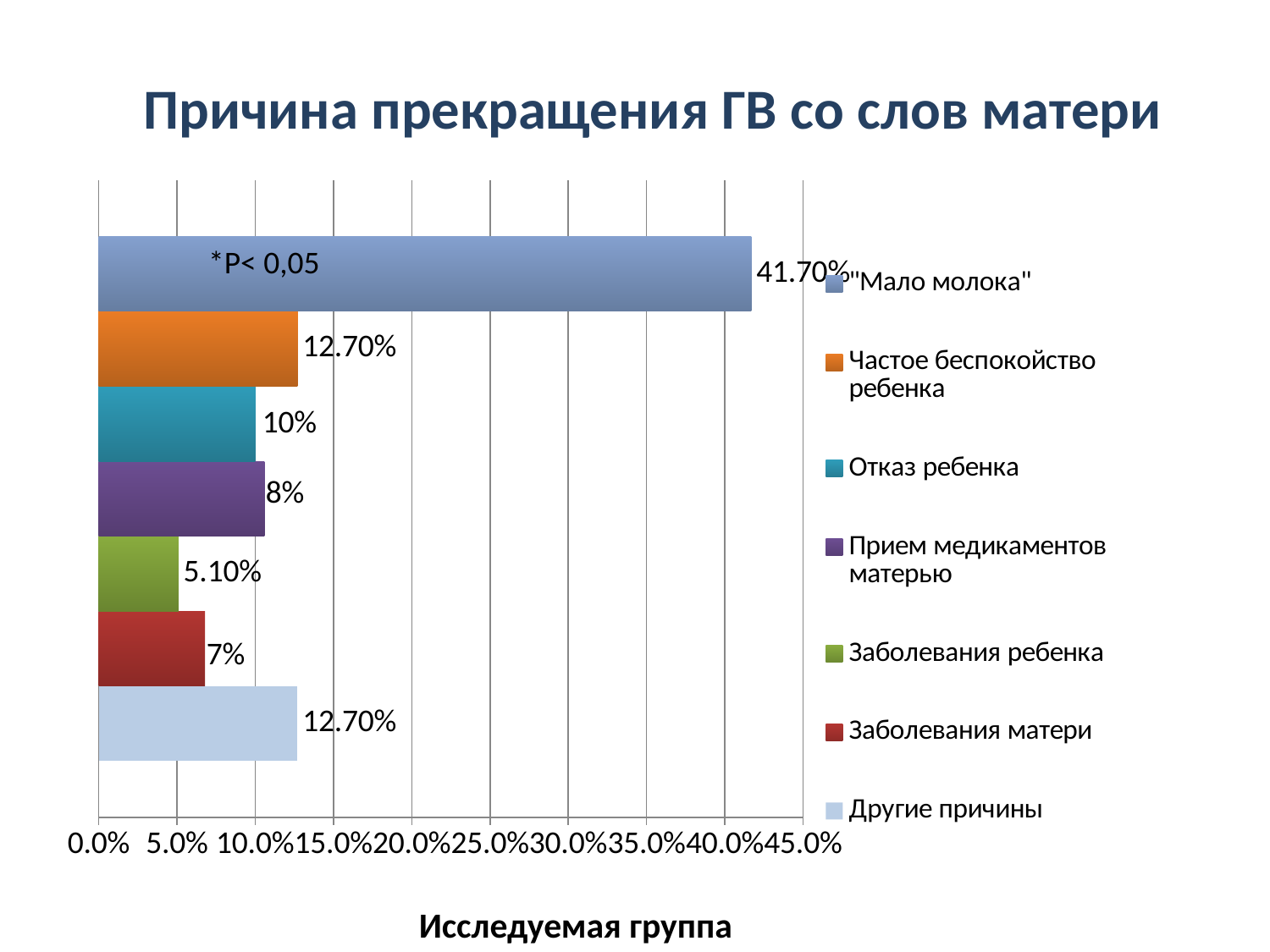
What is the difference between the values for "Мало молока" and Другие причины? 29% What is the value for "Мало молока"? 41.70% Which reason has the lowest value? Заболевания ребенка How many bars are plotted in the chart? 7 What is the value for Частое беспокойство ребенка? 12.70% What is the value for Заболевания ребенка? 5.10% What kind of chart is shown on the slide? bar chart Which reason has the highest value? "Мало молока" What is the value for Заболевания матери? 7% Which is larger, the value for Отказ ребенка or the value for Заболевания матери? Отказ ребенка Is the value for "Мало молока" greater or less than 40.0%? greater What is the title of the chart? Причина прекращения ГВ со слов матери